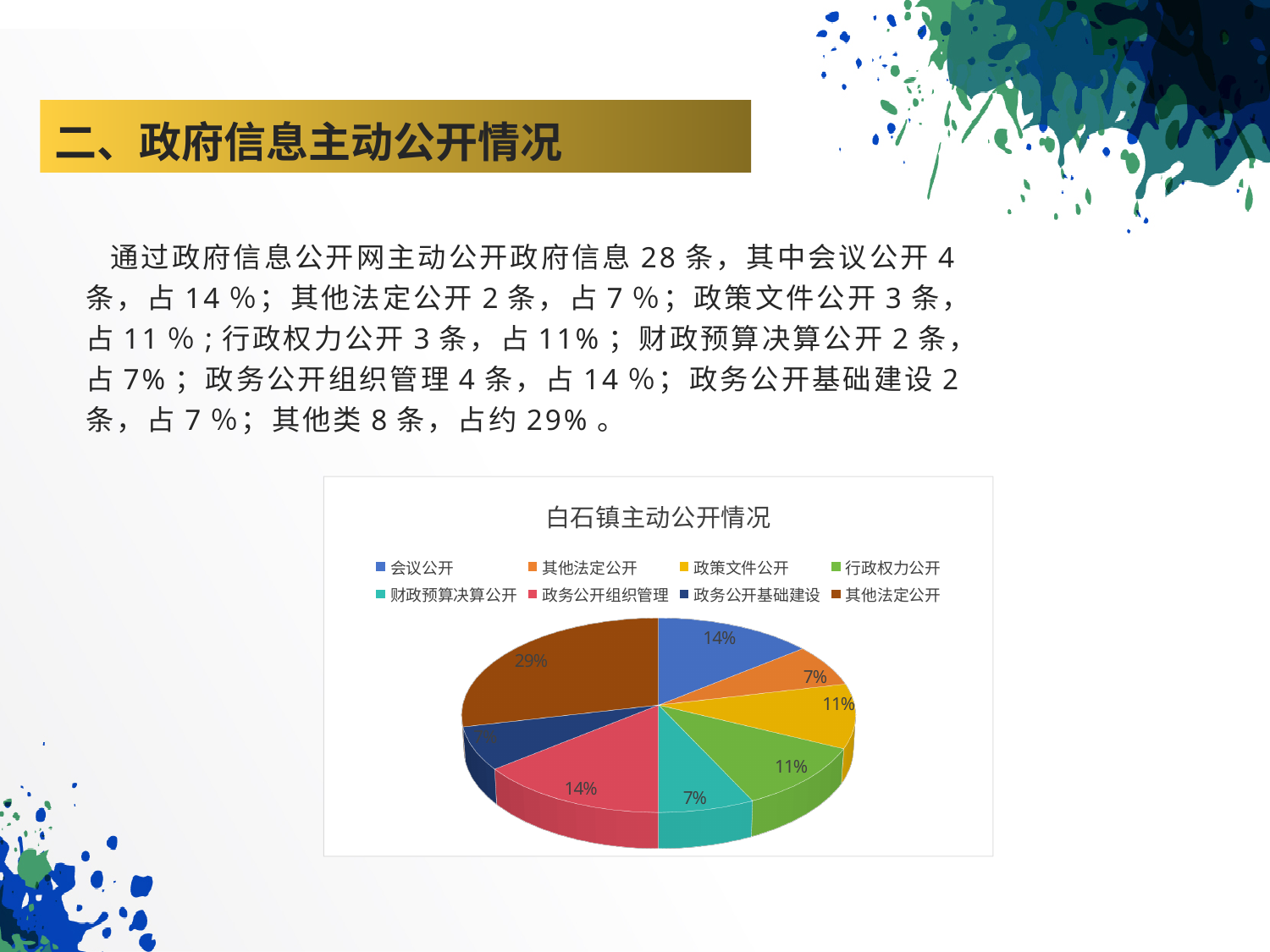
How many categories does the chart's legend list? 8 What colour is the 会议公开 slice in the chart? blue What is the title of the chart? 白石镇主动公开情况 What percentage does the 政策文件公开 slice show? 11% What percentage does the 财政预算决算公开 slice show? 7% What percentage does the 行政权力公开 slice show? 11% What is the largest percentage labelled on the pie chart? 29% What kind of chart is shown on the slide? pie chart What percentage does the 会议公开 slice show? 14% Which slice is larger, 会议公开 or 财政预算决算公开? 会议公开 By how many percentage points does 政务公开组织管理 exceed 财政预算决算公开? 7% What percentage does the 政务公开组织管理 slice show? 14%